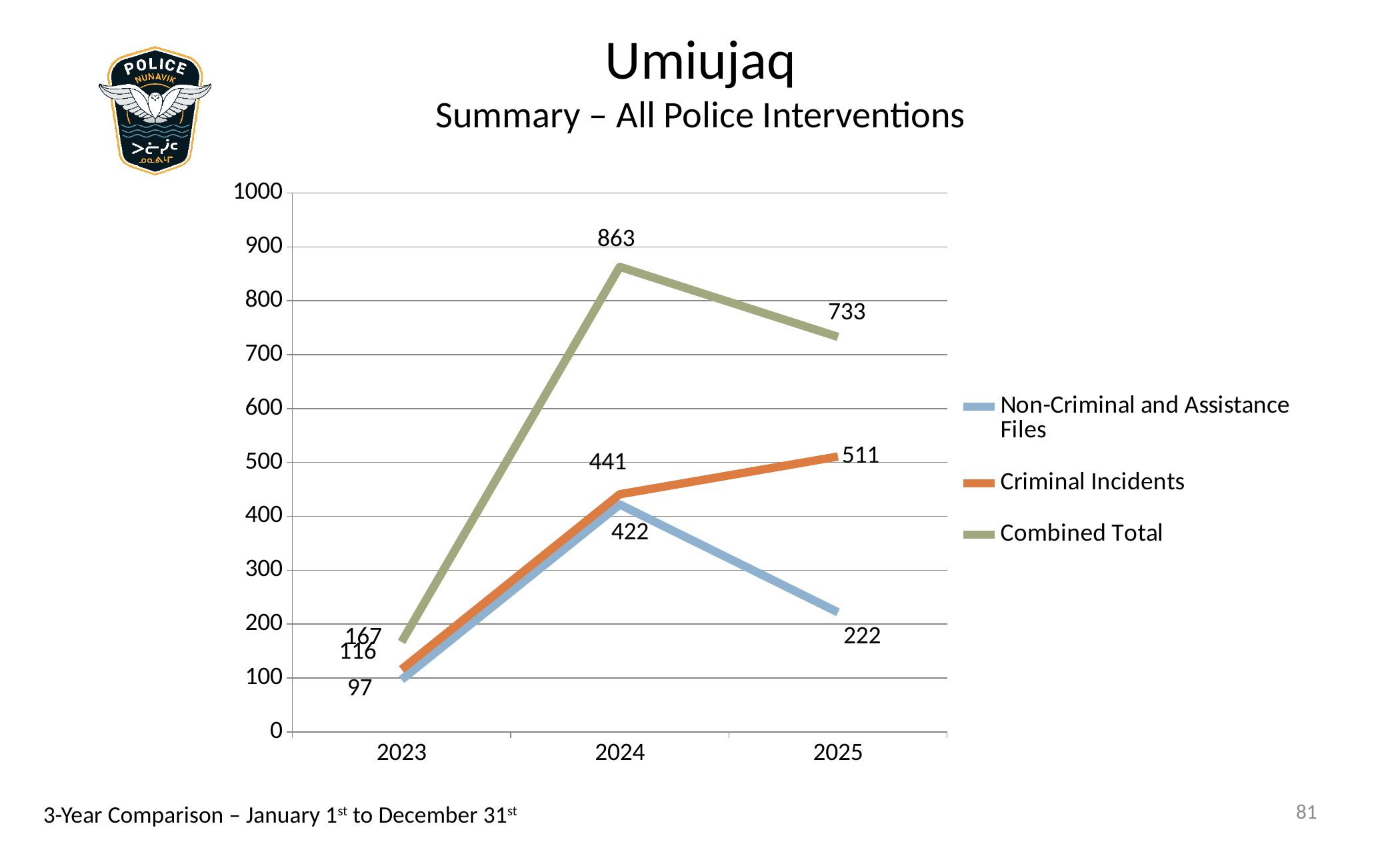
What is the difference between the Combined Total in 2024 and in 2025? 130 In which year is the Combined Total highest? 2024 How many years are shown on the x axis? 3 In which year is the Criminal Incidents value lowest? 2023 What kind of chart is shown on the slide? line chart Which is larger in 2025: Criminal Incidents or Non-Criminal and Assistance Files? Criminal Incidents What is the value for Non-Criminal and Assistance Files in 2023? 97 What is the Combined Total value for 2024? 863 How many series does the legend list? 3 Does the Criminal Incidents line rise or fall from 2023 to 2025? rise Is the Combined Total for 2023 greater or less than 200? less What is the value for Criminal Incidents in 2025? 511